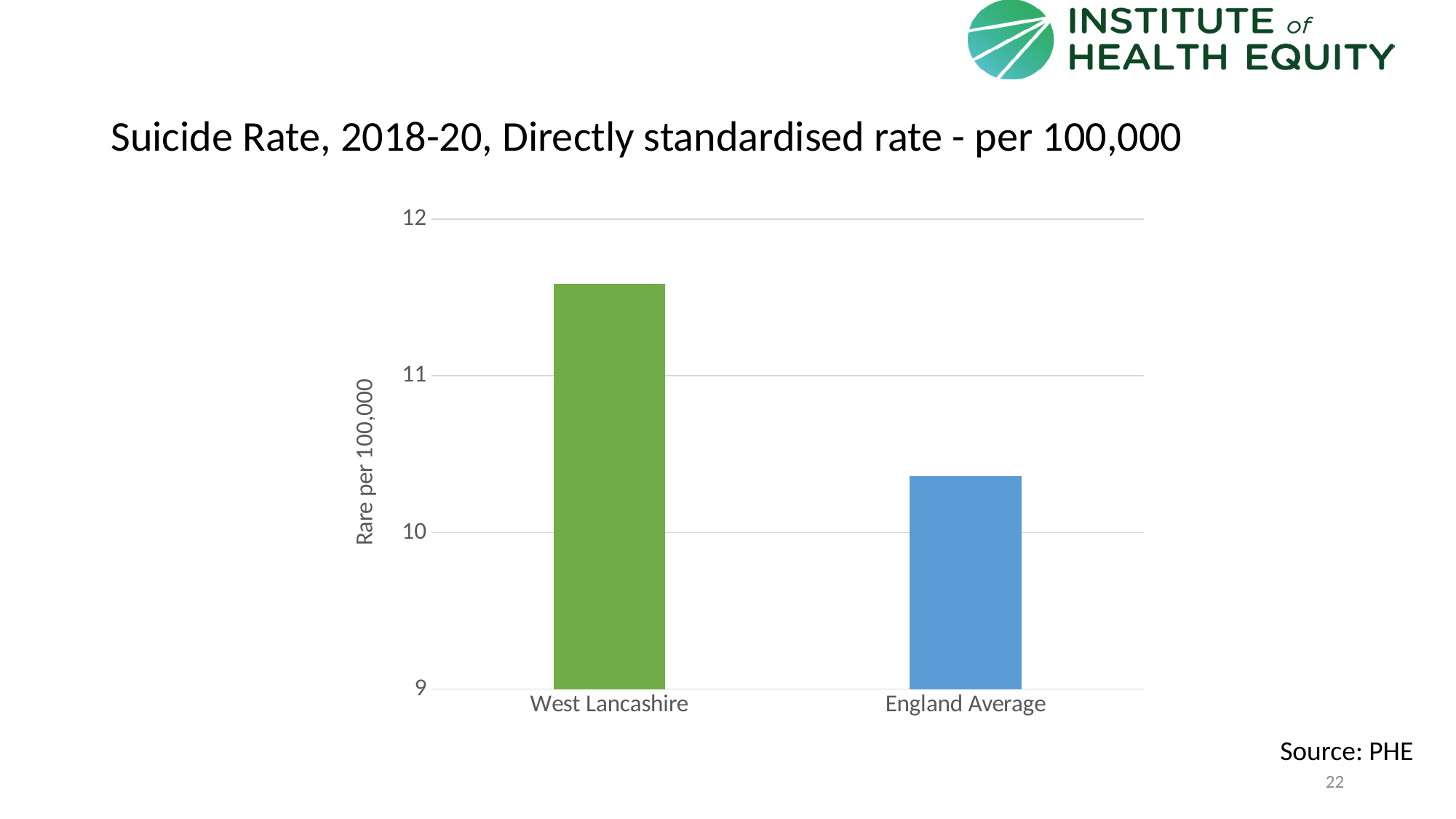
How many categories are shown on the chart? 2 What kind of chart is shown on the slide? Bar chart Is the suicide rate for England Average greater or less than 11? less Which is larger, the suicide rate for West Lancashire or for England Average? West Lancashire Is the suicide rate for England Average greater or less than 10? greater Is the suicide rate for West Lancashire greater or less than 12? less Which category has the highest suicide rate? West Lancashire What colour is the bar for West Lancashire? Green Which category has the lowest suicide rate? England Average What is the title of the chart? Suicide Rate, 2018-20, Directly standardised rate - per 100,000